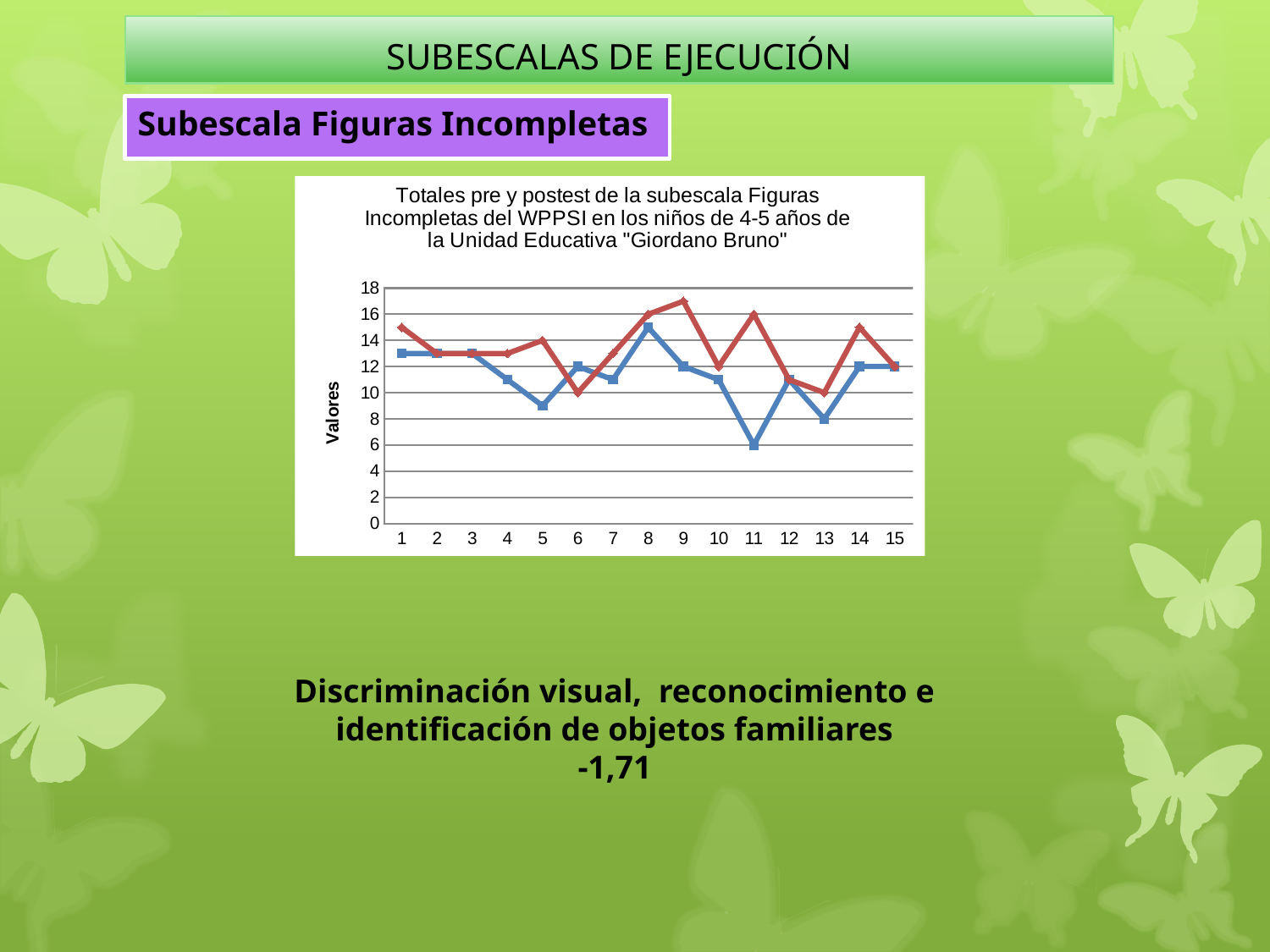
What is the value of the blue line at point 11? 6 How many lines (data series) are plotted in the chart? 2 What kind of chart is shown on the slide? line chart At which x-axis point does the blue line reach its lowest value? 11 What is the difference between the red line and the blue line at point 11? 10 What is the value of the blue line at point 13? 8 At which x-axis point does the red line reach its highest value? 9 What is the label of the vertical axis of the chart? Valores Is the value of the red line at point 9 greater or less than 16? greater At point 11, which line has the larger value, the red line or the blue line? red line How many points are plotted along the x axis of the chart? 15 What is the value of the red line at point 11? 16